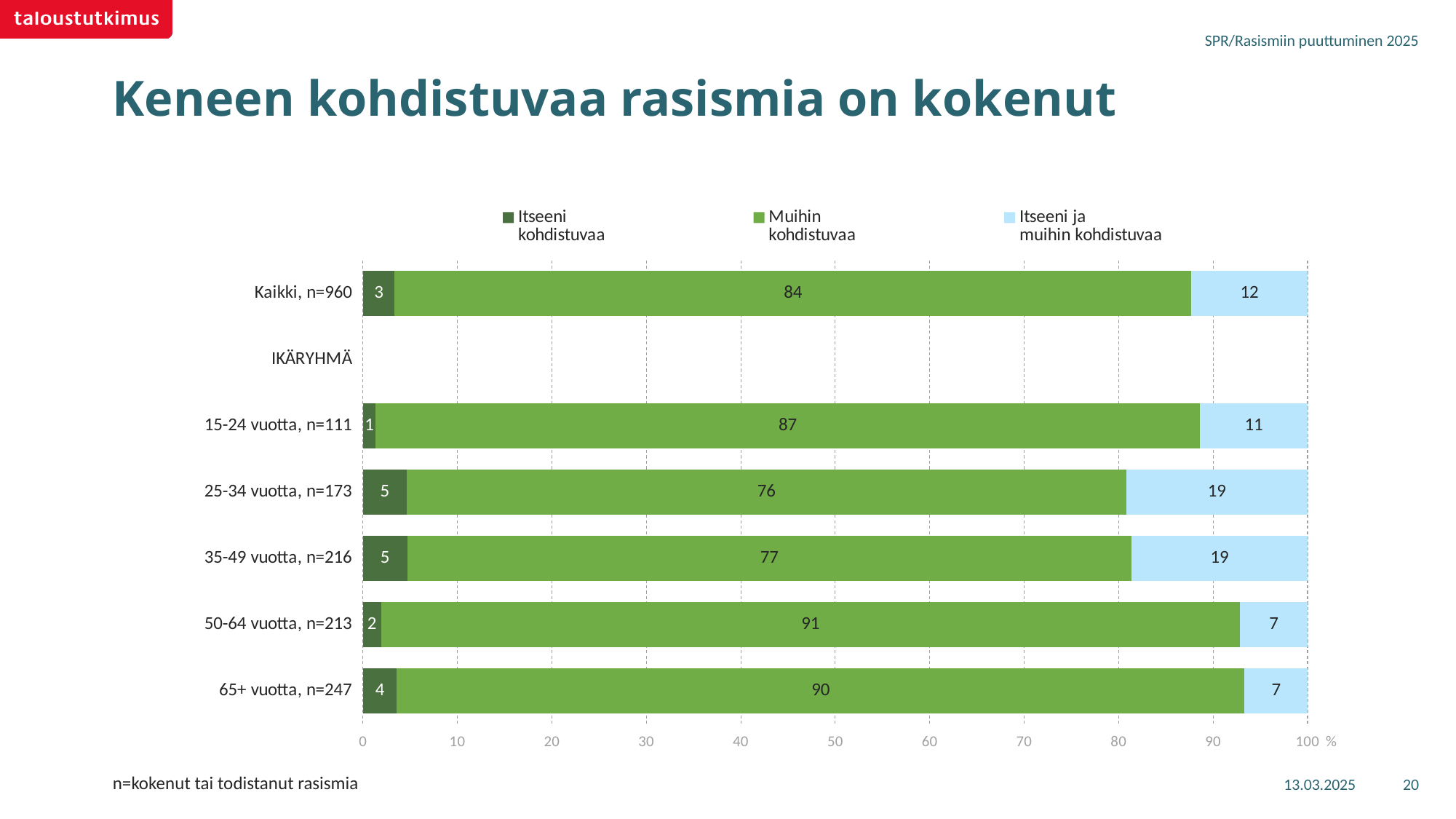
How many series does the legend list? 3 What kind of chart is shown on the slide? stacked bar chart What is the value of "Itseeni ja muihin kohdistuvaa" for "25-34 vuotta, n=173"? 19 Which age group has the lowest value for "Itseeni kohdistuvaa"? 15-24 vuotta, n=111 What is the value of "Itseeni kohdistuvaa" for "65+ vuotta, n=247"? 4 What is the total of the stacked bar for "15-24 vuotta, n=111"? 99 What is the difference between the "Muihin kohdistuvaa" values for "50-64 vuotta, n=213" and "25-34 vuotta, n=173"? 15 How many age groups are plotted under IKÄRYHMÄ? 5 Which age group has the highest value for "Muihin kohdistuvaa"? 50-64 vuotta, n=213 Which is larger: the "Itseeni ja muihin kohdistuvaa" value for "Kaikki, n=960" or for "50-64 vuotta, n=213"? Kaikki, n=960 What is the value of "Muihin kohdistuvaa" for "Kaikki, n=960"? 84 What is the title of the slide? Keneen kohdistuvaa rasismia on kokenut